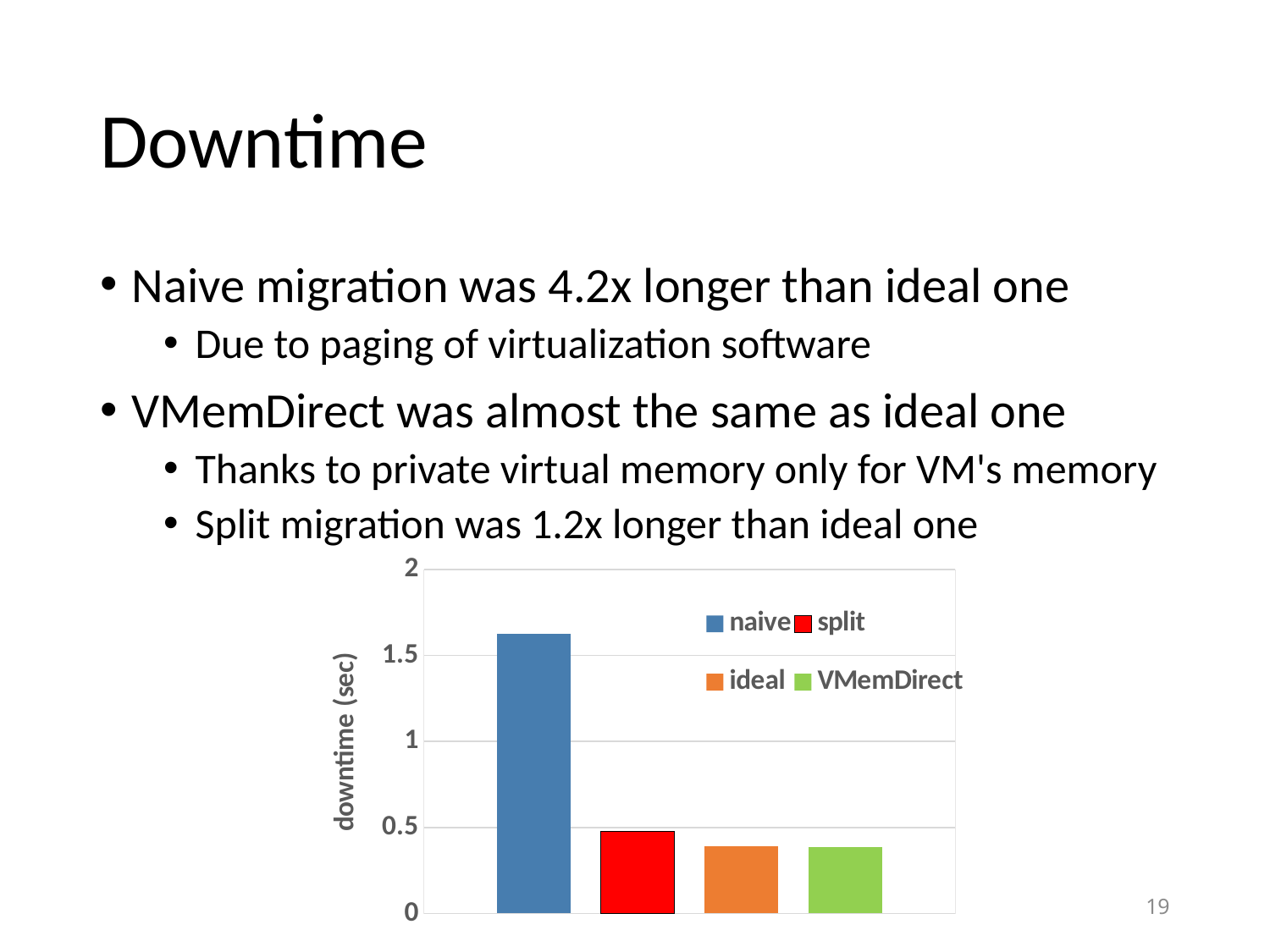
How many series does the chart's legend list? 4 Is the downtime for naive greater or less than 1.5? greater Which has a larger downtime, naive or split? naive Is the downtime for naive greater or less than 2? less What kind of chart is shown on the slide? bar chart Is the downtime for ideal greater or less than 0.5? less What is the label of the chart's vertical axis? downtime (sec) What colour is the bar for the split series? red Which series has the highest downtime in the chart? naive Which has a larger downtime, split or ideal? split